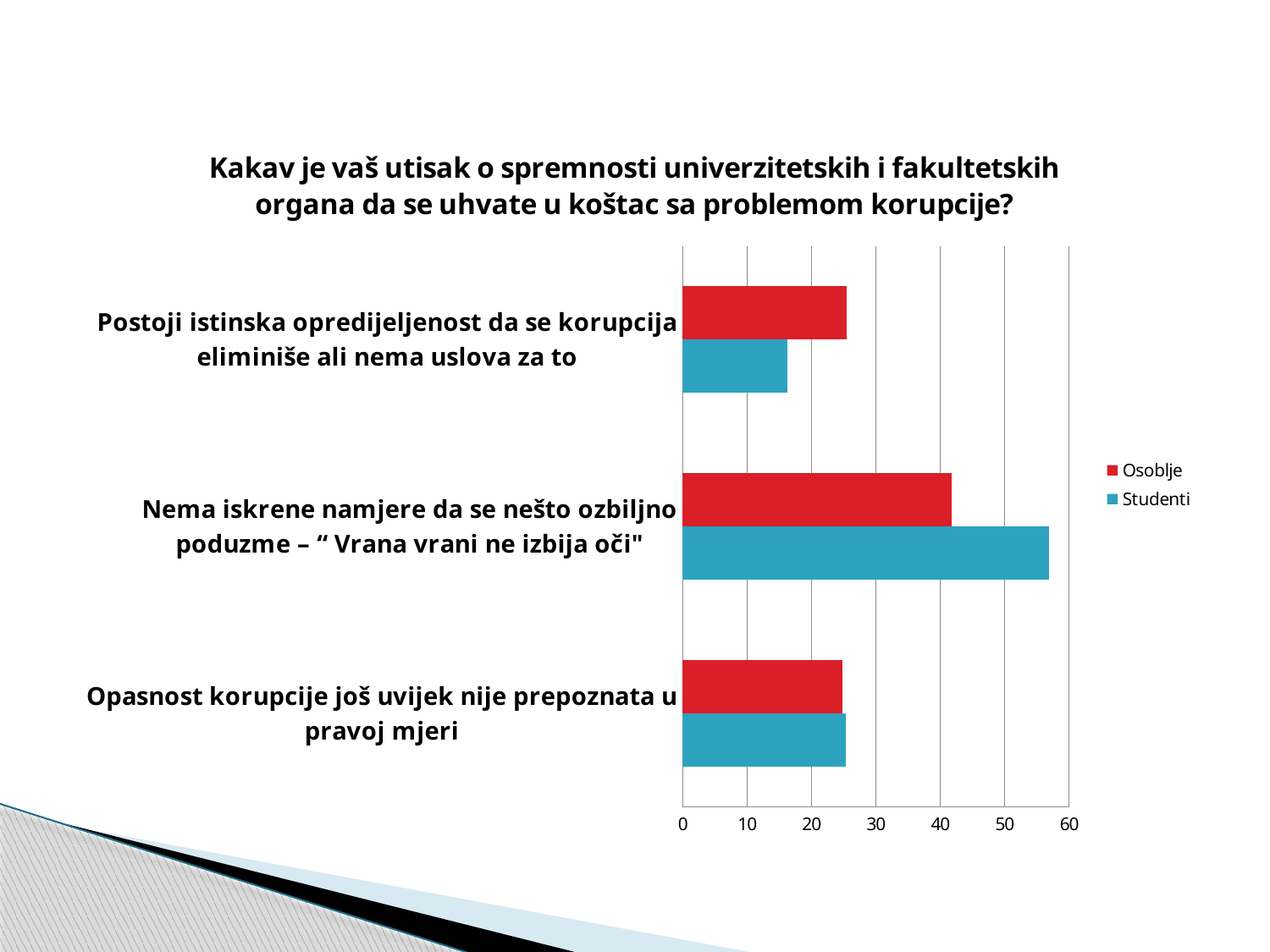
Is the Studenti value for "Nema iskrene namjere da se nešto ozbiljno poduzme" greater or less than 50? greater For which category is the Osoblje value highest? Nema iskrene namjere da se nešto ozbiljno poduzme – “ Vrana vrani ne izbija oči" How many series does the legend list? 2 Which series are listed in the legend? Osoblje, Studenti How many categories are shown on the chart? 3 What kind of chart is shown on the slide? bar chart For the category "Postoji istinska opredijeljenost da se korupcija eliminiše ali nema uslova za to", which series has the larger value, Osoblje or Studenti? Osoblje Is the Studenti value for "Postoji istinska opredijeljenost da se korupcija eliminiše ali nema uslova za to" greater or less than 20? less For which category is the Studenti value lowest? Postoji istinska opredijeljenost da se korupcija eliminiše ali nema uslova za to Is the Osoblje value for "Nema iskrene namjere da se nešto ozbiljno poduzme" greater or less than 40? greater For which category is the Studenti value highest? Nema iskrene namjere da se nešto ozbiljno poduzme – “ Vrana vrani ne izbija oči" For the category "Nema iskrene namjere da se nešto ozbiljno poduzme", which series has the larger value, Osoblje or Studenti? Studenti